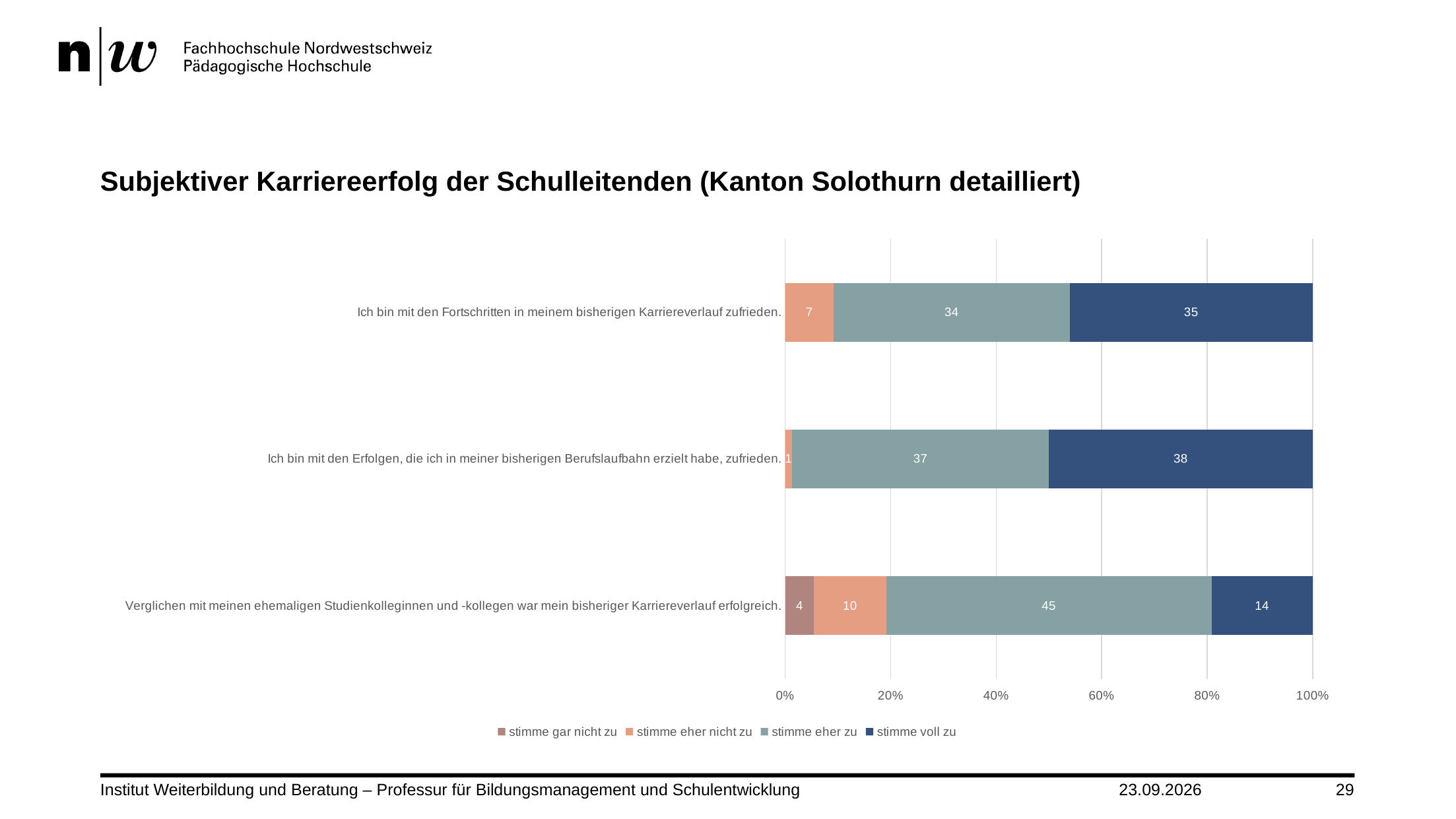
What is the value for "stimme eher zu" for the statement "Vergleichen mit meinen ehemaligen Studienkolleginnen und -kollegen war mein bisheriger Karriereverlauf erfolgreich."? 45 Which statement has the highest value for "stimme voll zu"? Ich bin mit den Erfolgen, die ich in meiner bisherigen Berufslaufbahn erzielt habe, zufrieden. How many series does the legend list? 4 What kind of chart is shown on the slide? stacked bar chart How many statements (categories) are plotted in the chart? 3 What is the value for "stimme eher nicht zu" for the statement "Ich bin mit den Erfolgen, die ich in meiner bisherigen Berufslaufbahn erzielt habe, zufrieden."? 1 What is the value for "stimme voll zu" for the statement "Ich bin mit den Fortschritten in meinem bisherigen Karriereverlauf zufrieden."? 35 What is the value for "stimme gar nicht zu" for the statement "Verglichen mit meinen ehemaligen Studienkolleginnen und -kollegen war mein bisheriger Karriereverlauf erfolgreich."? 4 For the statement "Ich bin mit den Fortschritten in meinem bisherigen Karriereverlauf zufrieden.", which is larger: the "stimme eher zu" value or the "stimme voll zu" value? stimme voll zu What is the difference between the "stimme eher zu" value and the "stimme voll zu" value for the statement "Verglichen mit meinen ehemaligen Studienkolleginnen und -kollegen war mein bisheriger Karriereverlauf erfolgreich."? 31 Which statement has the lowest value for "stimme voll zu"? Verglichen mit meinen ehemaligen Studienkolleginnen und -kollegen war mein bisheriger Karriereverlauf erfolgreich. What is the title of the chart on the slide? Subjektiver Karriereerfolg der Schulleitenden (Kanton Solothurn detailliert)